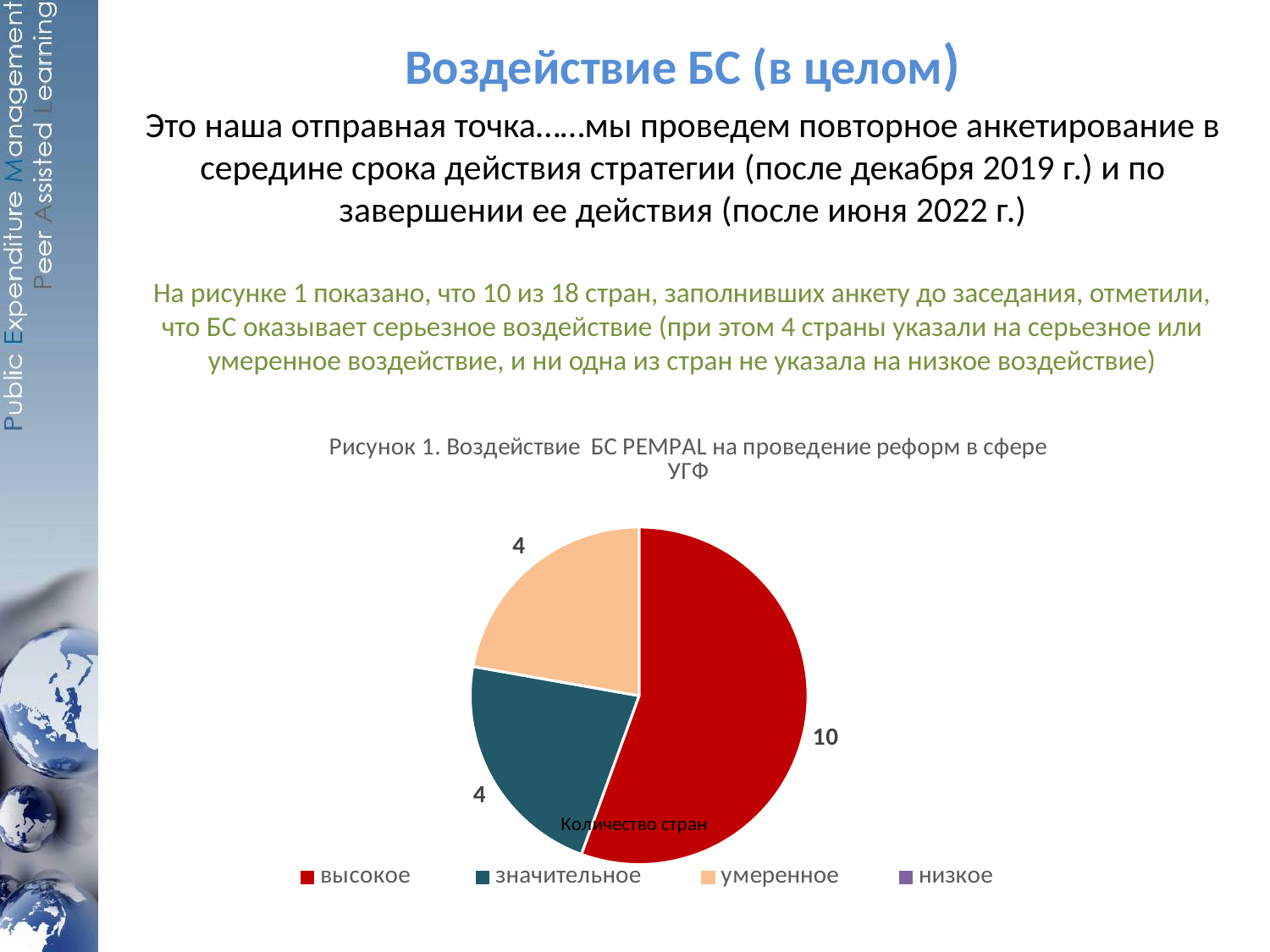
What value is shown for the "умеренное" slice? 4 How many countries are in the "высокое" slice of the pie chart? 10 How many slices are visible in the pie chart? 3 What colour is the "высокое" slice? red How many entries does the legend list? 4 Which is larger, the "высокое" slice or the "умеренное" slice? высокое What value is shown for the "значительное" slice? 4 Which legend entry has no visible slice in the pie chart? низкое Which category has the largest slice in the pie chart? высокое What type of chart is shown on the slide? pie chart What is the total number of countries across all slices of the pie chart? 18 What is the difference between the "высокое" and "значительное" values? 6